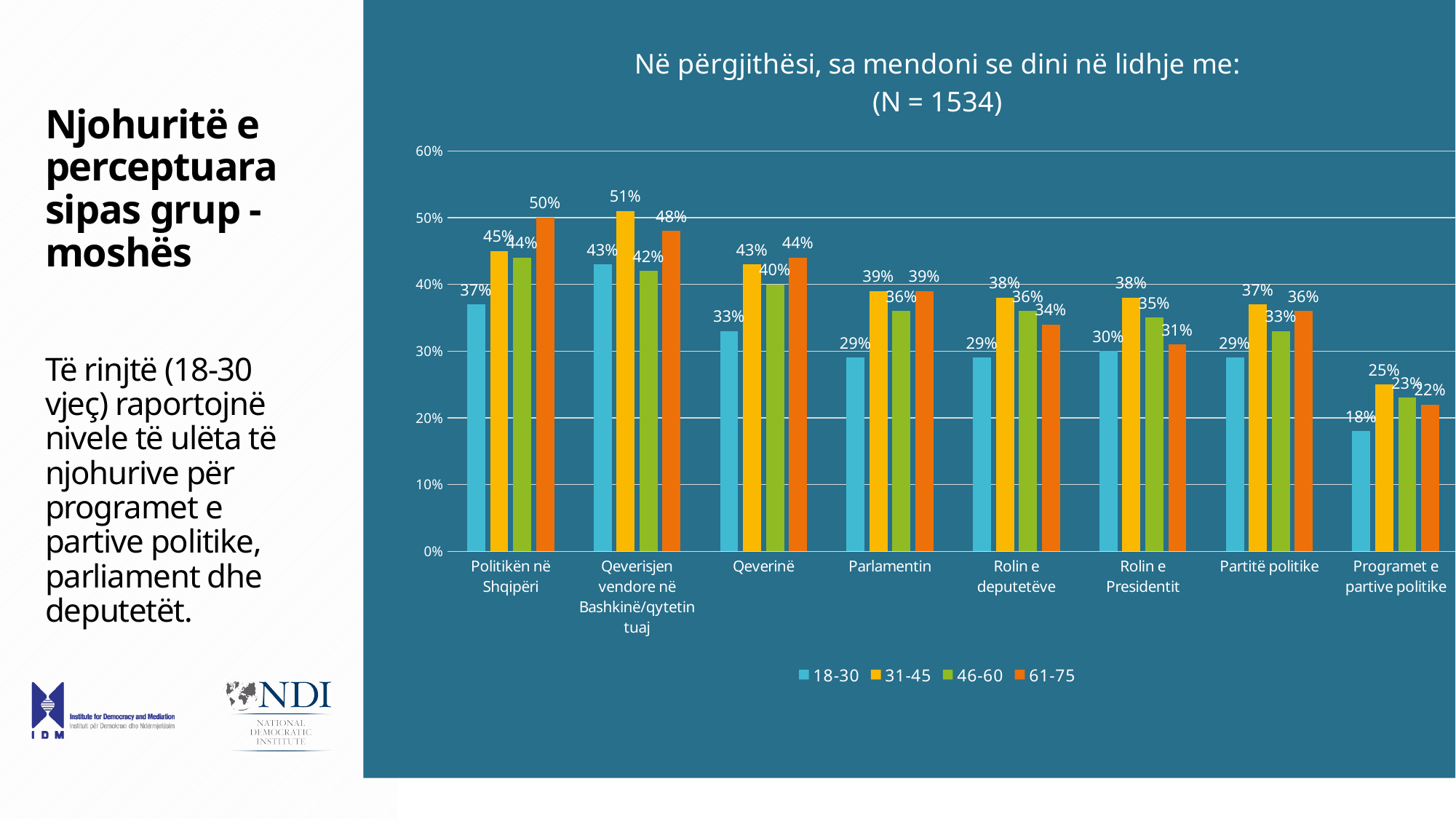
Is the value for the 18-30 group for 'Qeverinë' greater or less than 40%? less For 'Rolin e Presidentit', which group has the larger value: 46-60 or 61-75? 46-60 What sample size (N) is stated in the chart title? N = 1534 What is the value for the 61-75 group for 'Politikën në Shqipëri'? 50% How many age-group series does the legend list? 4 What is the difference between the 61-75 and 18-30 values for 'Politikën në Shqipëri'? 13 percentage points How many categories are shown on the x axis? 8 Which category has the highest value for the 31-45 group? Qeverisjen vendore në Bashkinë/qytetin tuaj What is the value for the 31-45 group for 'Qeverisjen vendore në Bashkinë/qytetin tuaj'? 51% Which category has the lowest value for the 18-30 group? Programet e partive politike What kind of chart is shown on the slide? Bar chart What is the value for the 18-30 group for 'Programet e partive politike'? 18%